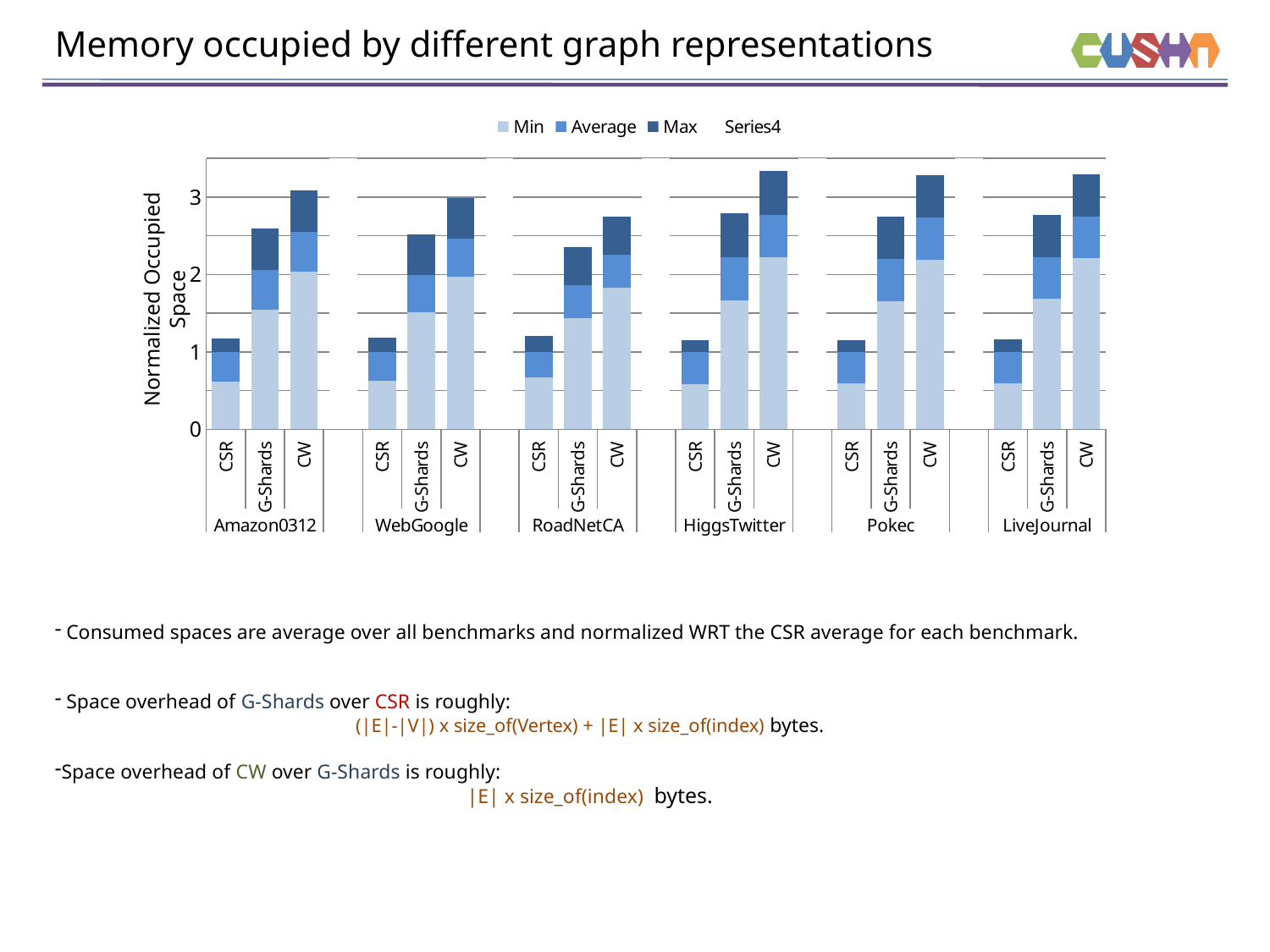
How many entries does the chart legend list? 4 Is the total stacked value for CSR in the Pokec group greater or less than 1? greater In the RoadNetCA group, which has the larger total stacked value, G-Shards or CW? CW How many bars are plotted in the chart in total? 18 Is the total stacked value for CW in the RoadNetCA group greater or less than 3? less How many benchmark groups are shown along the x axis of the chart? 6 Within the LiveJournal group, which representation has the shortest stacked bar? CSR What is the label of the y axis of the chart? Normalized Occupied Space Is the total stacked value for CW in the HiggsTwitter group greater or less than 3? greater Within the WebGoogle group, which representation has the tallest stacked bar? CW What kind of chart is shown on the slide? stacked bar chart